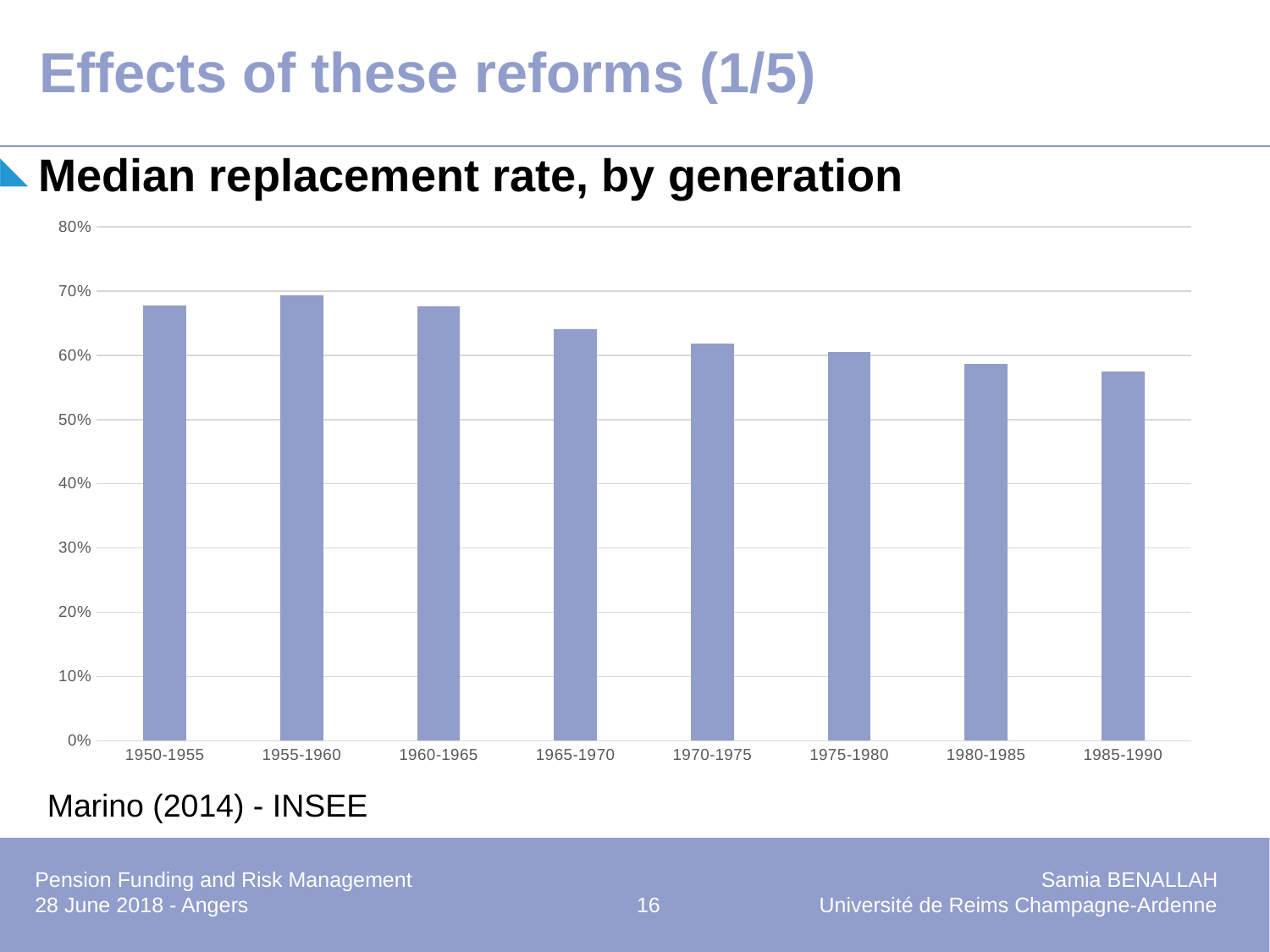
Does the median replacement rate generally rise or fall from the 1955-1960 generation to the 1985-1990 generation? fall Which generation has the highest median replacement rate? 1955-1960 Which generation has a higher median replacement rate, 1965-1970 or 1980-1985? 1965-1970 Which generation has the lowest median replacement rate? 1985-1990 What kind of chart is shown on the slide? bar chart Is the median replacement rate for the 1965-1970 generation greater or less than 60%? greater Is the median replacement rate for the 1985-1990 generation greater or less than 60%? less What source is cited below the chart? Marino (2014) - INSEE Is the median replacement rate for the 1950-1955 generation greater or less than 60%? greater Which generation has a higher median replacement rate, 1955-1960 or 1985-1990? 1955-1960 How many generation categories are shown on the x axis? 8